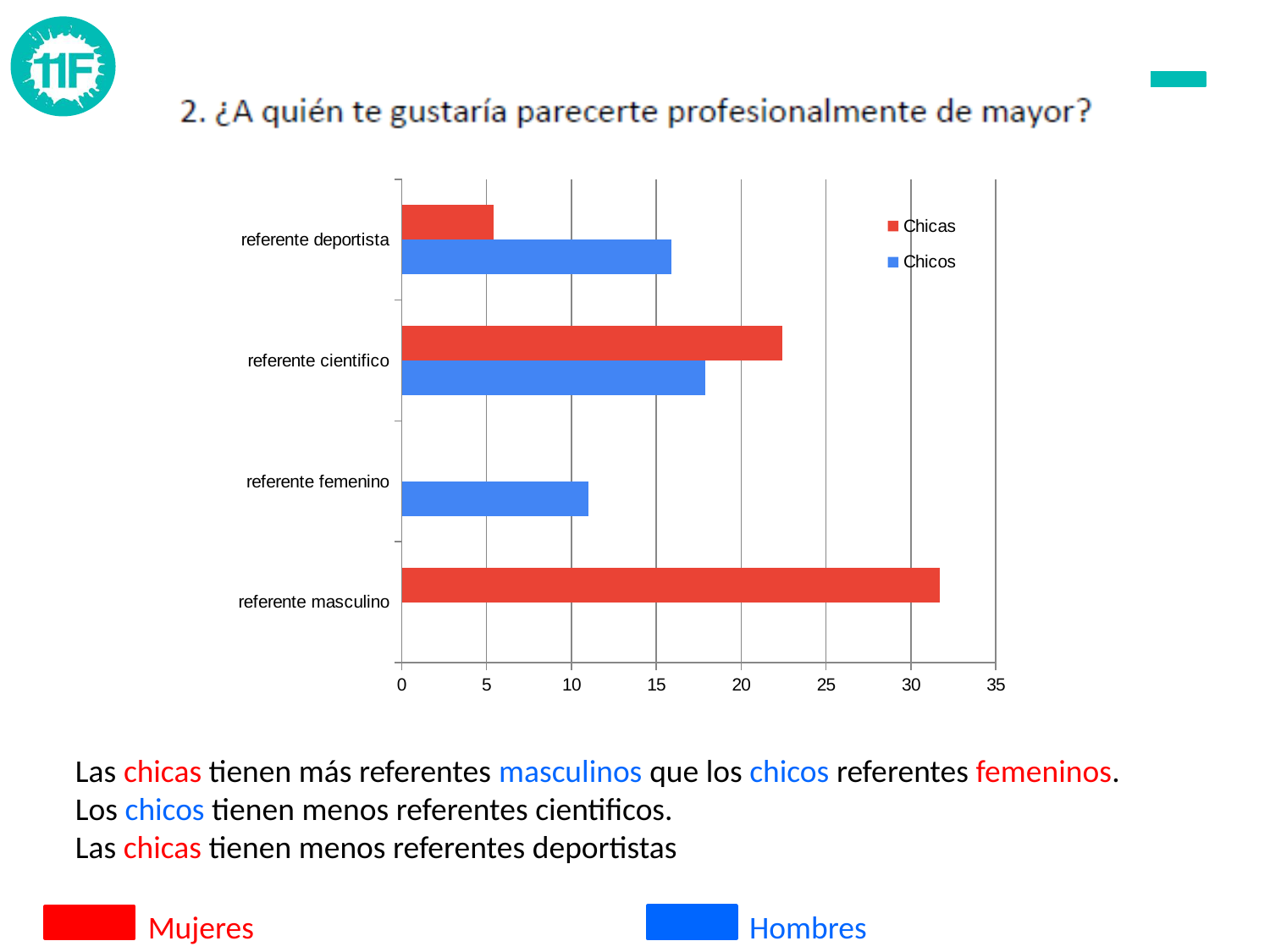
Is the Chicas value for referente deportista greater or less than 10? less Is the Chicos value for referente cientifico greater or less than 20? less Which category has the highest value for the Chicas series? referente masculino Which category has the highest value for the Chicos series? referente cientifico How many series does the chart legend list? 2 What kind of chart is shown on the slide? bar chart How many categories are shown on the chart's vertical axis? 4 For referente deportista, which series has the larger value, Chicas or Chicos? Chicos Is the Chicas value for referente masculino greater or less than 30? greater What colour represents the Chicas series in the chart? red For referente cientifico, which series has the larger value, Chicas or Chicos? Chicas